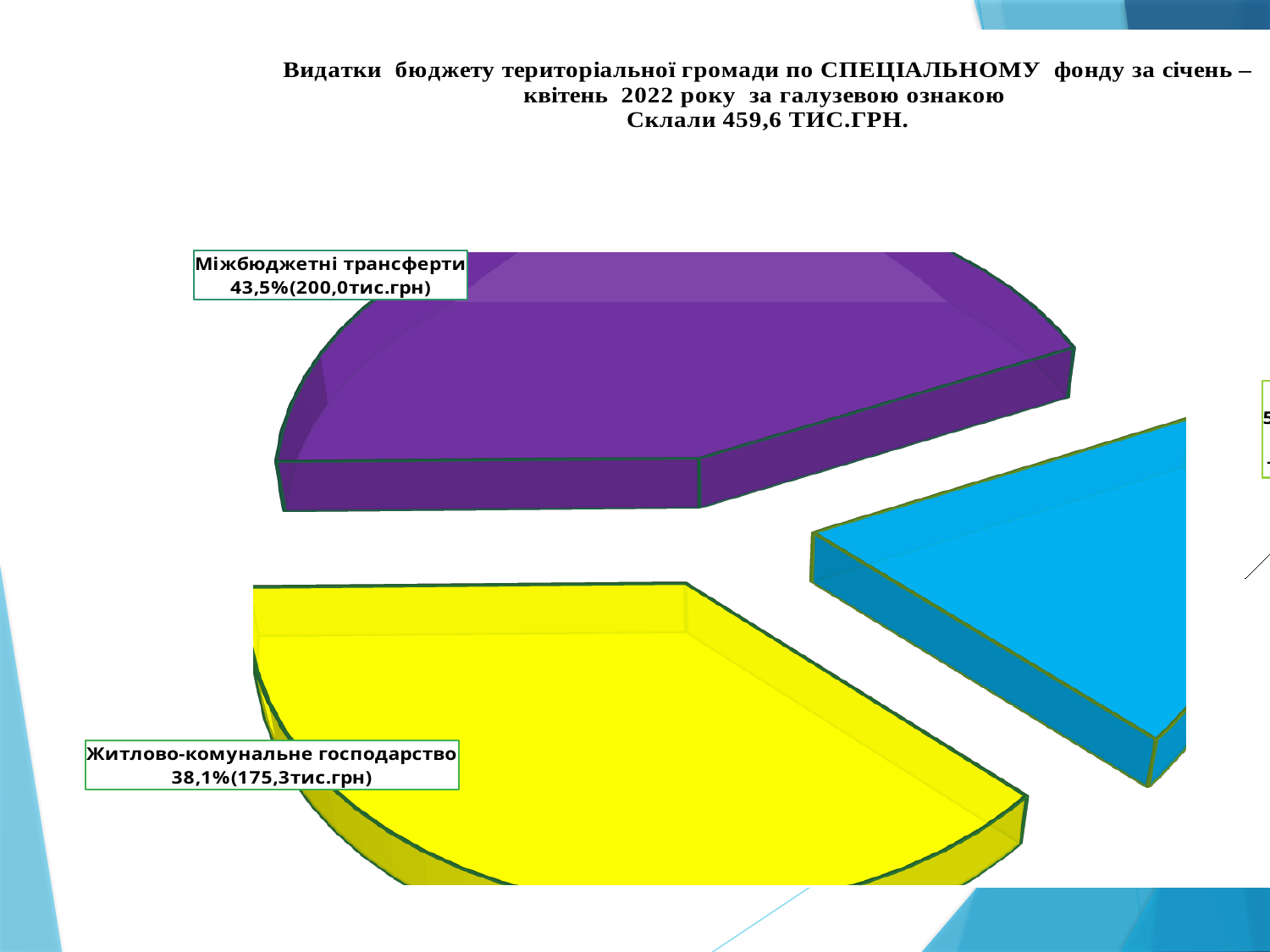
What is the difference in percentage points between the share for Міжбюджетні трансферти and the share for Житлово-комунальне господарство? 5,4 What kind of chart is shown on the slide? pie chart What colour is the slice for Житлово-комунальне господарство? yellow What share of the pie does Міжбюджетні трансферти account for? 43,5% What share of the pie does Житлово-комунальне господарство account for? 38,1% According to the chart title, what total did the special fund expenditures amount to? 459,6 ТИС.ГРН. What is the value shown for Міжбюджетні трансферти in тис.грн? 200,0тис.грн Is the share for Житлово-комунальне господарство greater or less than 40%? less What is the difference in тис.грн between the value for Міжбюджетні трансферти and the value for Житлово-комунальне господарство? 24,7 Which is larger, the share for Міжбюджетні трансферти or the share for Житлово-комунальне господарство? Міжбюджетні трансферти What is the value shown for Житлово-комунальне господарство in тис.грн? 175,3тис.грн